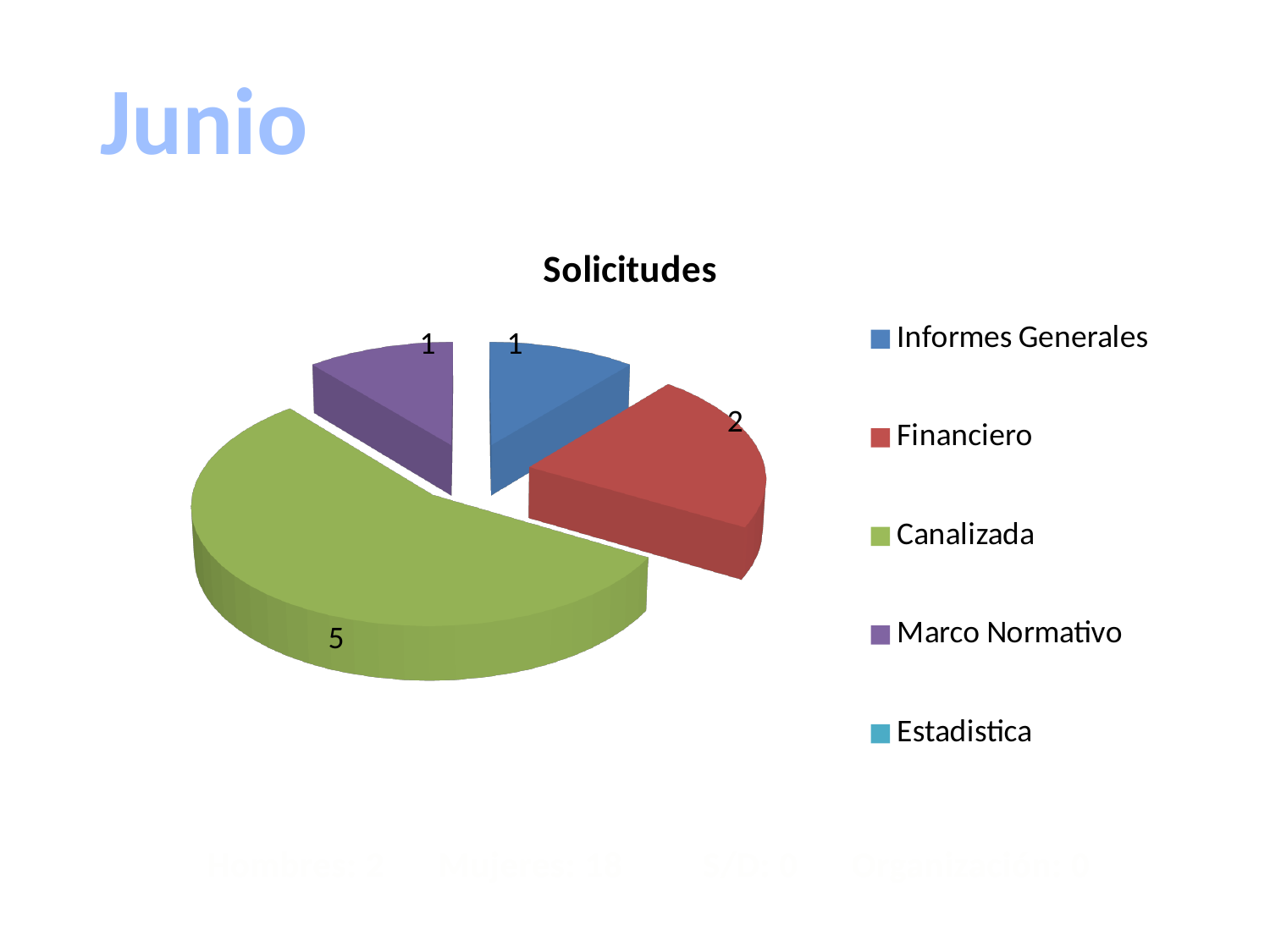
What is the value for Canalizada in the Solicitudes chart? 5 How many categories does the legend of the Solicitudes chart list? 5 What is the value for Financiero in the Solicitudes chart? 2 Which is larger in the Solicitudes chart, Financiero or Informes Generales? Financiero What colour is the Canalizada slice in the chart? green Which category has the largest slice in the Solicitudes chart? Canalizada What is the value for Informes Generales in the Solicitudes chart? 1 What is the difference between the values for Canalizada and Financiero? 3 What is the difference between the values for Financiero and Marco Normativo? 1 What kind of chart is shown on the slide? pie chart What is the title of the chart? Solicitudes What is the value for Marco Normativo in the Solicitudes chart? 1